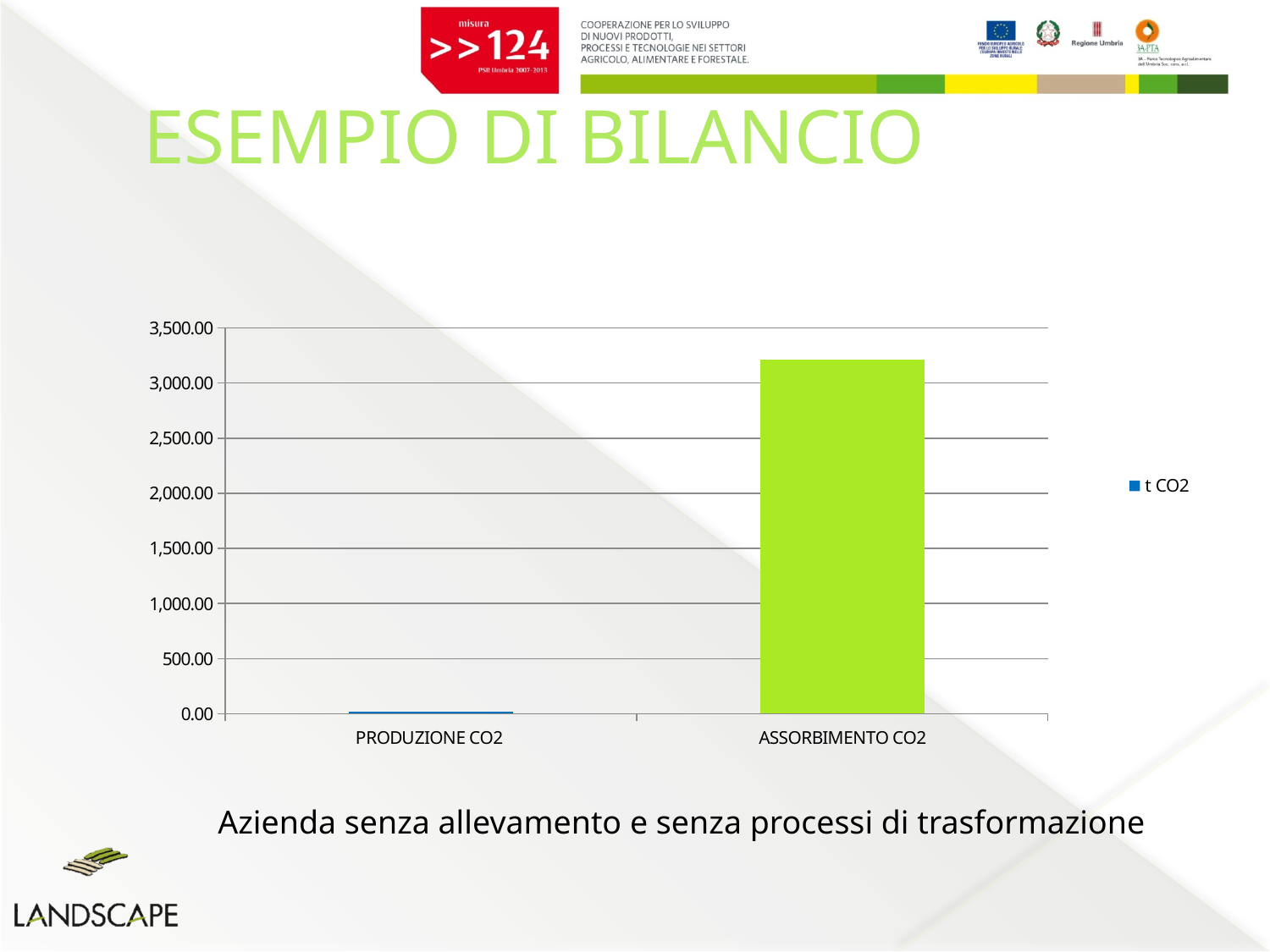
Is the value for ASSORBIMENTO CO2 greater or less than 3,000.00? greater Is the value for ASSORBIMENTO CO2 greater or less than 3,500.00? less Which is larger, the value for PRODUZIONE CO2 or the value for ASSORBIMENTO CO2? ASSORBIMENTO CO2 What is the highest value labelled on the vertical axis of the chart? 3,500.00 Is the value for PRODUZIONE CO2 greater or less than 500.00? less What kind of chart is shown on the slide? bar chart Which category has the lowest value in the chart? PRODUZIONE CO2 What is the series name shown in the chart legend? t CO2 Which category has the highest value in the chart? ASSORBIMENTO CO2 How many categories are shown on the x axis of the chart? 2 How many series does the chart legend list? 1